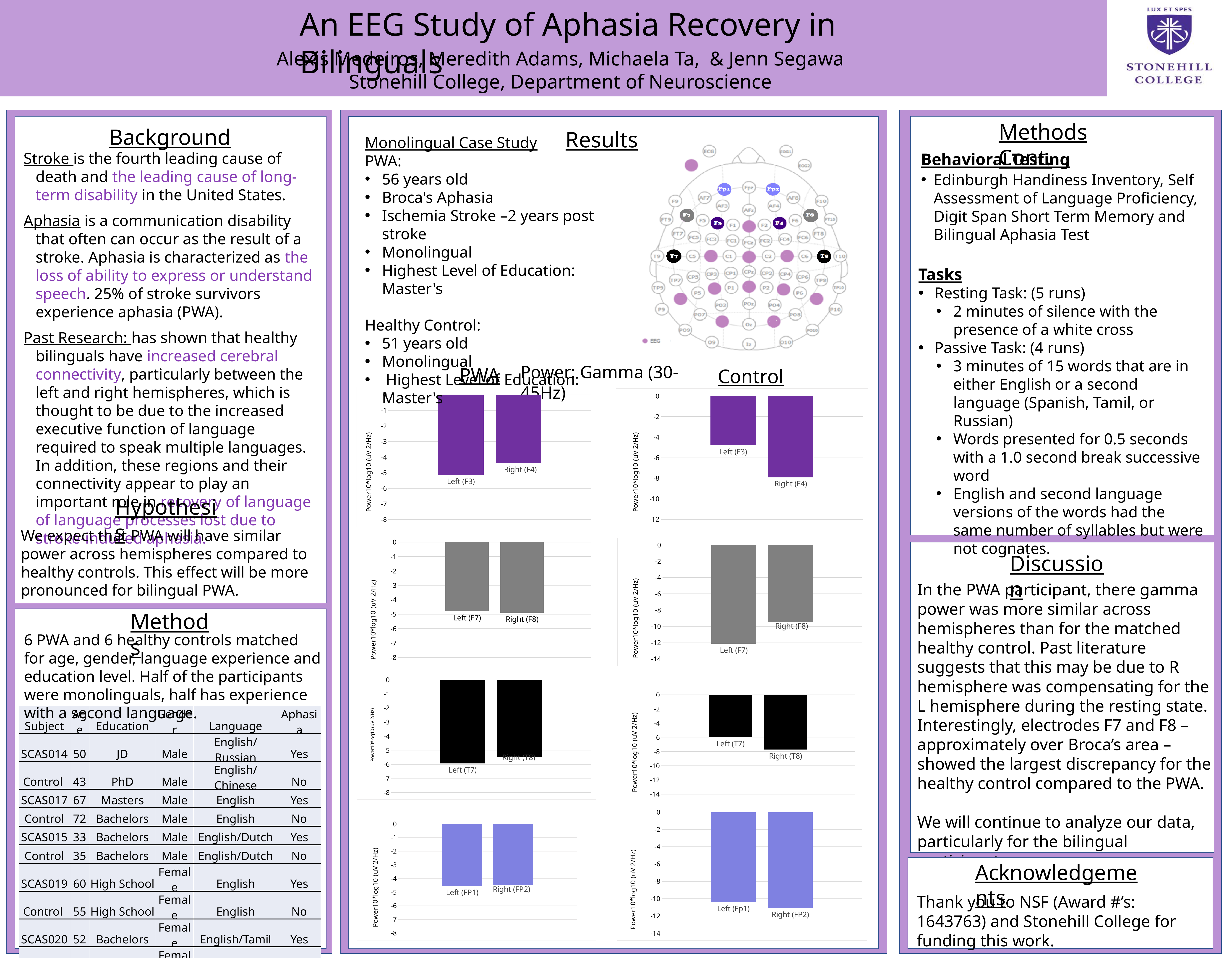
In the Control chart for Left (T7) and Right (T8), which bar extends further below zero? Right (T8) In the Control chart for Left (F7) and Right (F8), which bar extends further below zero? Left (F7) In the Control chart for Left (Fp1) and Right (FP2), is the value for Left (Fp1) greater or less than -8? less How many bar charts are shown in the Results section under the PWA and Control columns? 8 In the Control chart for Left (F7) and Right (F8), is the value for Left (F7) greater or less than -10? less In the Control chart for Left (F3) and Right (F4), is the value for Right (F4) greater or less than -6? less In the PWA chart for Left (F3) and Right (F4), which bar extends further below zero? Left (F3) What kind of chart is the PWA chart for Left (F3) and Right (F4)? bar chart What is the title shown above the PWA and Control bar charts? Power: Gamma (30-45Hz) How many categories does the Control chart for Left (F3) and Right (F4) show? 2